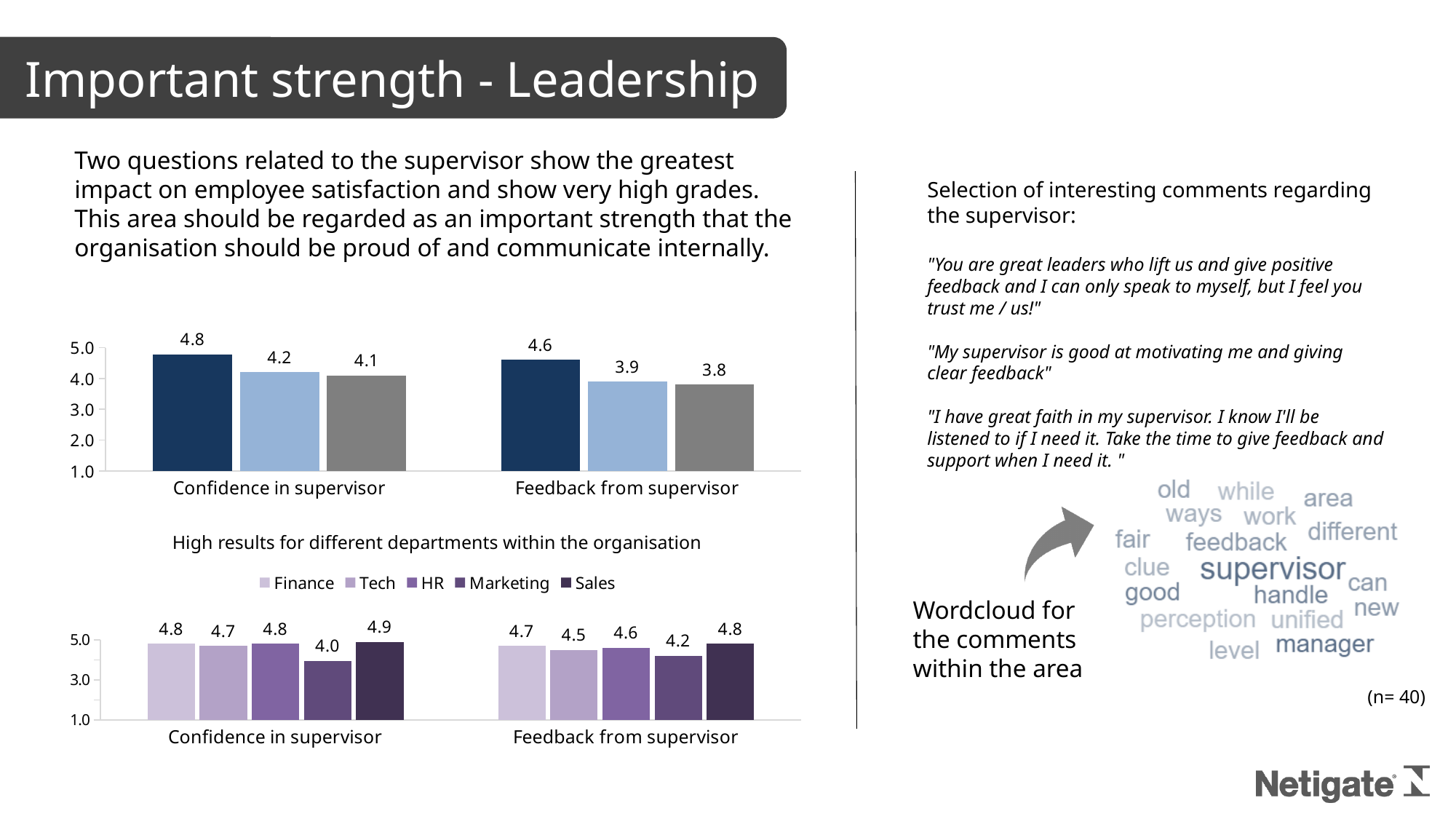
In the top chart, what is the difference between the dark blue bar and the grey bar for Confidence in supervisor? 0.7 In the bottom chart (High results for different departments within the organisation), which department has the lowest value for Confidence in supervisor? Marketing In the bottom chart (High results for different departments within the organisation), what is the difference between the Sales and Marketing values for Confidence in supervisor? 0.9 In the top chart, what is the lowest value shown for Feedback from supervisor? 3.8 In the bottom chart (High results for different departments within the organisation), what is the value for Sales under Confidence in supervisor? 4.9 In the bottom chart (High results for different departments within the organisation), what is the value for Marketing under Feedback from supervisor? 4.2 In the bottom chart (High results for different departments within the organisation), is the value for HR under Feedback from supervisor larger or smaller than the value for Marketing? larger In the bottom chart (High results for different departments within the organisation), which department has the highest value for Feedback from supervisor? Sales What kind of chart is the top chart on the slide? Bar chart In the bottom chart (High results for different departments within the organisation), what is the value for Tech under Feedback from supervisor? 4.5 In the top chart, what is the value of the dark blue bar for Feedback from supervisor? 4.6 How many series does the legend of the bottom chart (High results for different departments within the organisation) list? 5